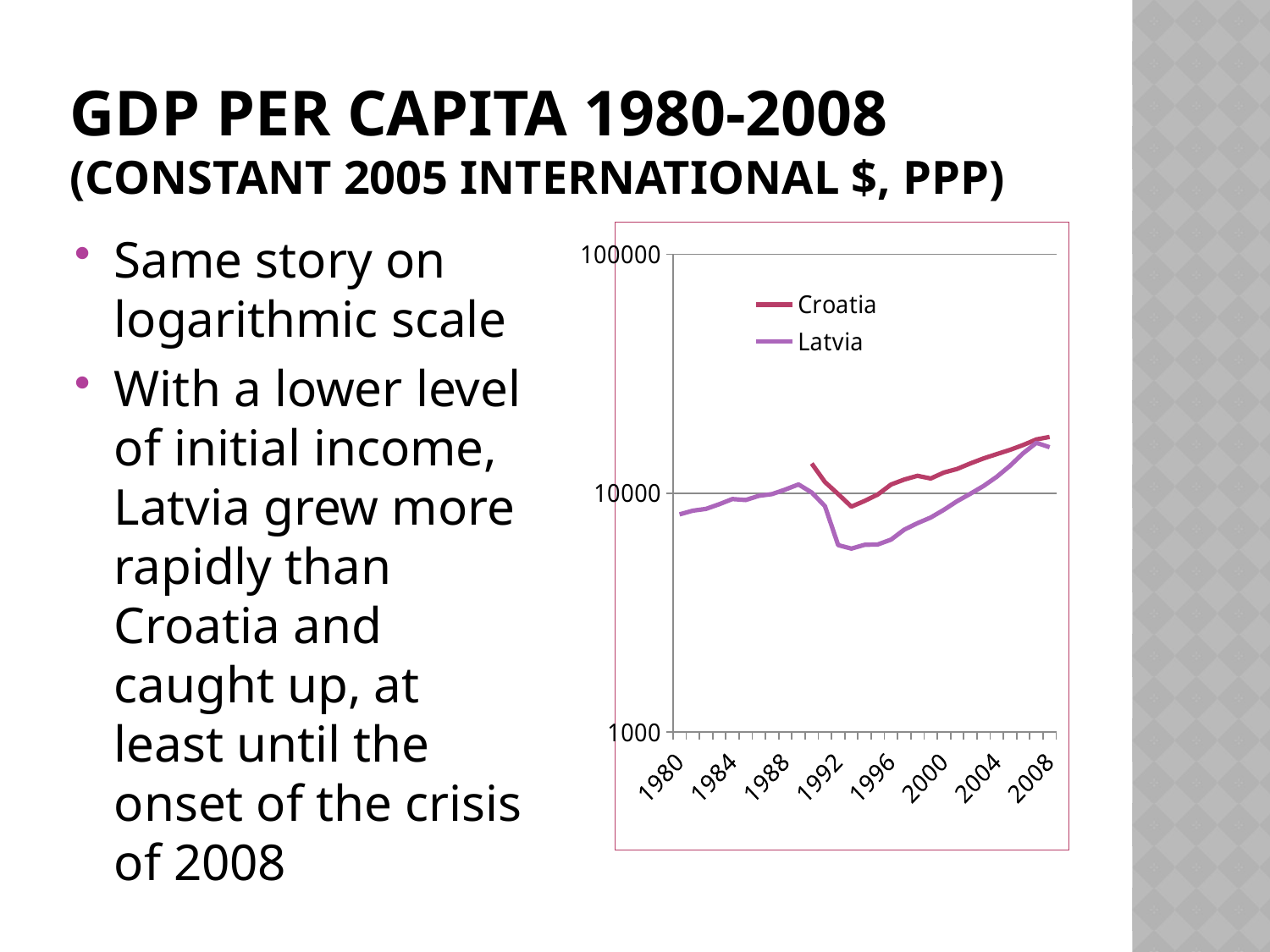
Which country has the higher GDP per capita in 2000, Croatia or Latvia? Croatia Which two countries are plotted in the chart? Croatia and Latvia How many year labels are shown on the x axis of the chart? 8 Is the value for Latvia in 1980 greater or less than 10000? less Is the value for Latvia in 1993 greater or less than 10000? less Does the Latvia line rise or fall between 1994 and 2008? rise Which series is drawn in purple in the chart? Latvia What kind of chart is shown on the slide? line chart How many series does the chart's legend list? 2 Is the value for Latvia in 2008 greater or less than 10000? greater Which country has the higher GDP per capita in 1996, Croatia or Latvia? Croatia